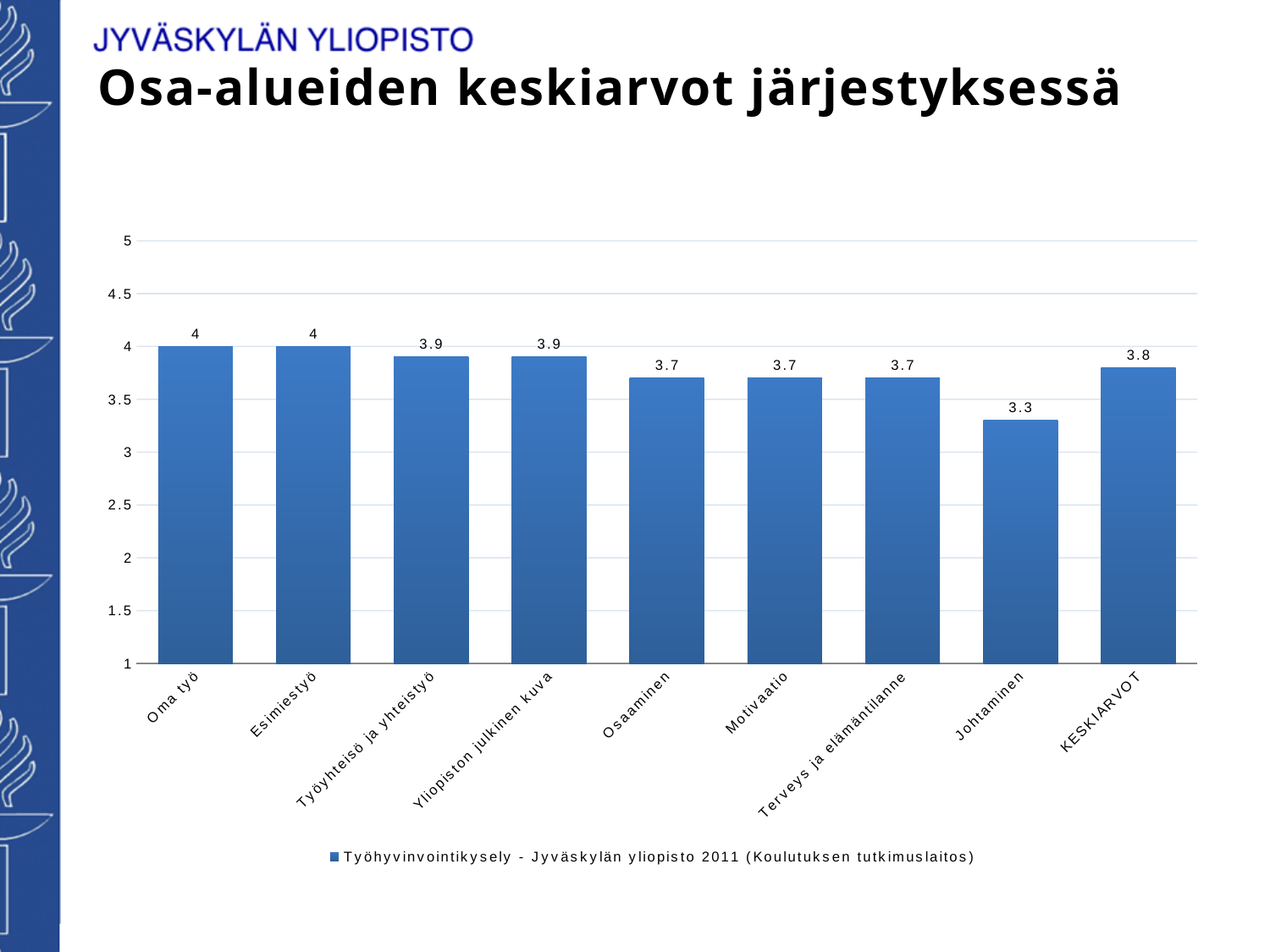
What is the value for KESKIARVOT? 3.8 What kind of chart is shown on the slide? bar chart Which is larger, the value for Esimiestyö or the value for Motivaatio? Esimiestyö What is the difference between the values for Oma työ and Johtaminen? 0.7 How many series does the legend list? 1 What is the value for Johtaminen? 3.3 Which category has the lowest value? Johtaminen What is the value for Osaaminen? 3.7 How many categories are shown on the x axis? 9 What is the title of the slide? Osa-alueiden keskiarvot järjestyksessä What is the value for Työyhteisö ja yhteistyö? 3.9 Is the value for Johtaminen greater or less than 3.5? less